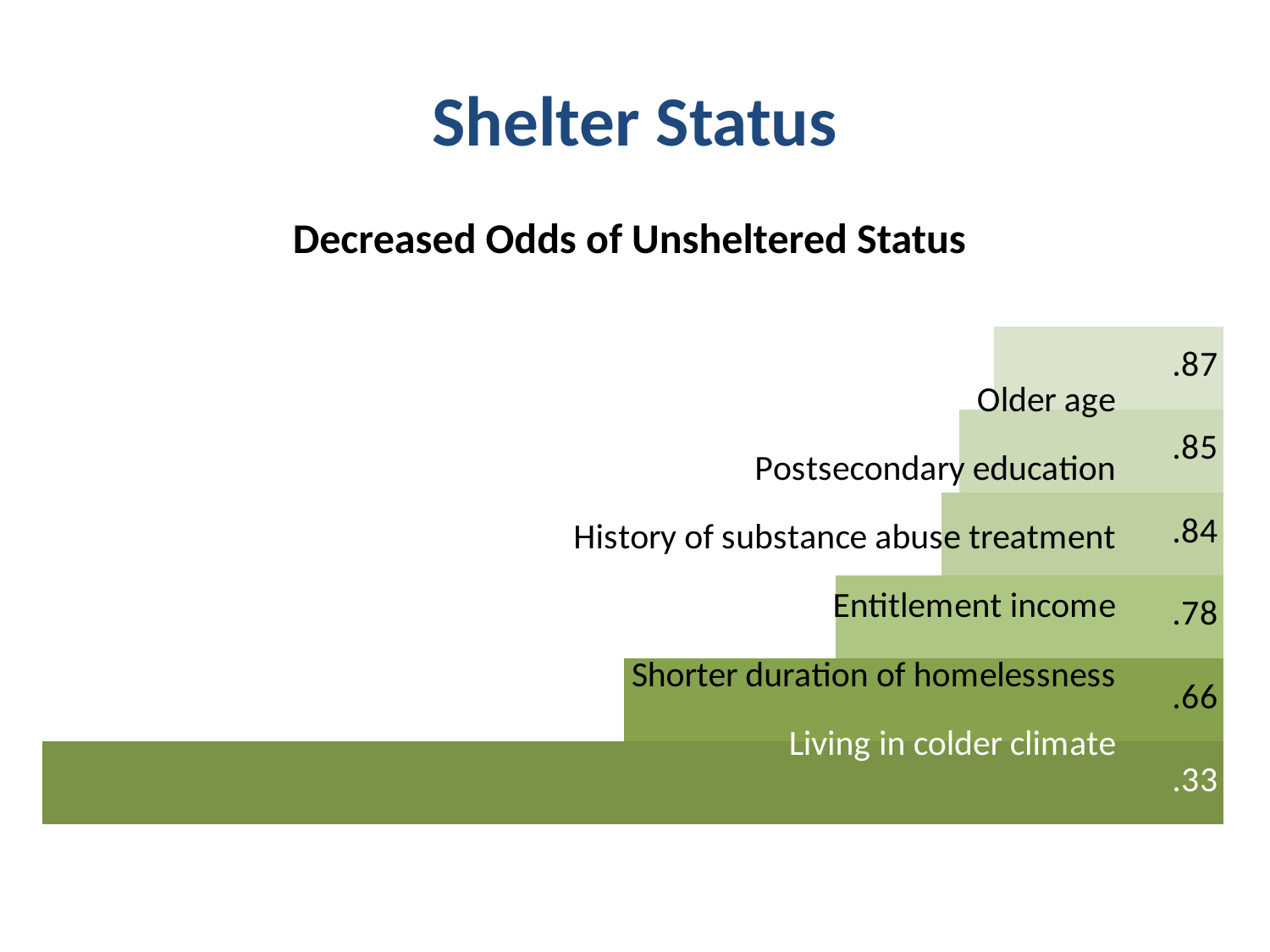
What is the title of the chart? Decreased Odds of Unsheltered Status How many categories are shown in the chart? 6 What is the value shown for Living in colder climate? .33 What is the value shown for Shorter duration of homelessness? .66 What is the difference between the values for Entitlement income and Shorter duration of homelessness? .12 What is the value shown for Entitlement income? .78 What is the value shown for Older age? .87 Which category has the lowest value? Living in colder climate Which category has the highest value? Older age What kind of chart is shown on the slide? Bar chart What is the difference between the values for Older age and Living in colder climate? .54 Which has a larger value, Postsecondary education or Entitlement income? Postsecondary education